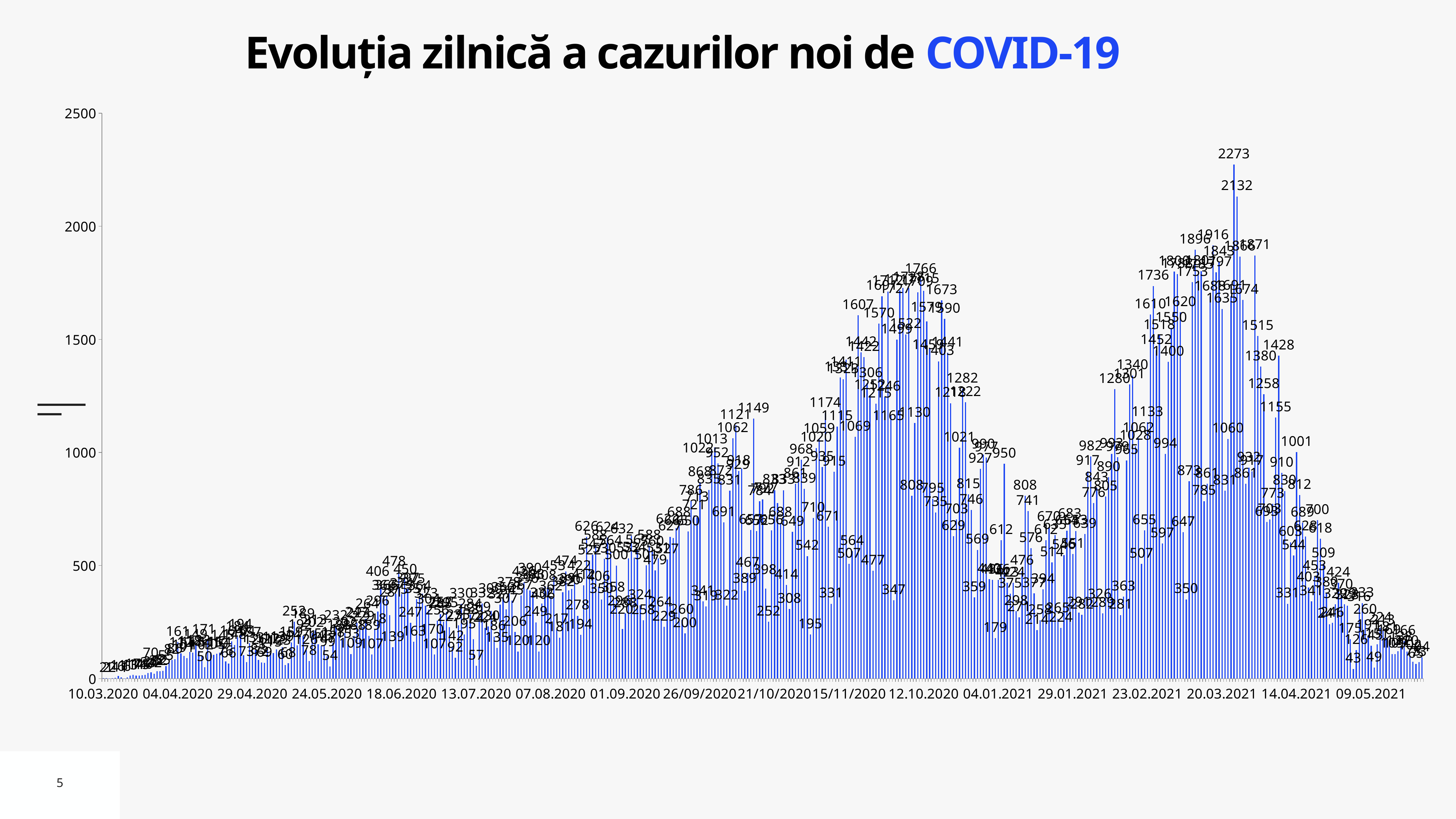
What is the highest value marked on the vertical axis? 2500 Between 10.03.2020 and 04.04.2020, do the daily values generally rise or fall? rise What kind of chart is shown on the slide? bar chart What is the highest daily value shown in the chart? 2273 What is the difference between the spring 2021 peak of 2273 and the autumn 2020 peak of 1766? 507 Is the highest value in the chart greater or less than 2000? greater Between 14.04.2021 and 09.05.2021, do the daily values generally rise or fall? fall What is the difference between the two highest labelled values, 2273 and 2132? 141 Are the values at the start of the chart (around 10.03.2020) greater or less than 500? less Which is larger: the peak value of the autumn 2020 wave (1766) or the peak value of the spring 2021 wave (2273)? 2273 What is the second-highest labelled value, shown on the bar right after the 2273 peak? 2132 What is the title of the chart? Evoluția zilnică a cazurilor noi de COVID-19